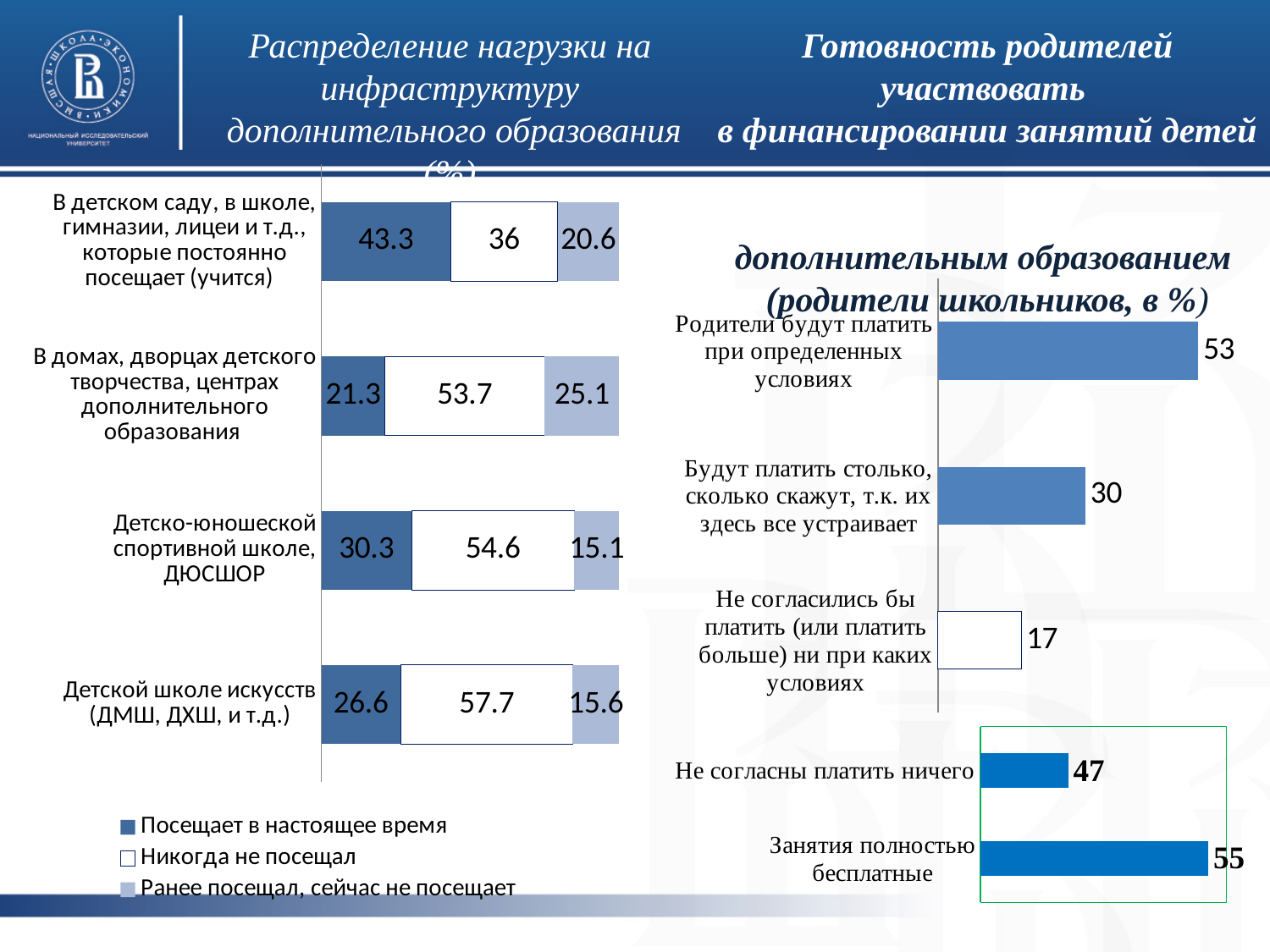
In the left chart, how many series does the legend list? 3 In the left chart, what is the value of 'Ранее посещал, сейчас не посещает' for 'В домах, дворцах детского творчества, центрах дополнительного образования'? 25.1 In the left chart 'Распределение нагрузки на инфраструктуру дополнительного образования', what is the value of 'Посещает в настоящее время' for 'Детско-юношеской спортивной школе, ДЮСШОР'? 30.3 What type of chart is the left chart? Stacked bar chart In the left chart, what is the difference between 'Никогда не посещал' and 'Посещает в настоящее время' for 'В домах, дворцах детского творчества, центрах дополнительного образования'? 32.4 In the right-top chart, which category has the lowest value? Не согласились бы платить (или платить больше) ни при каких условиях In the right-bottom chart, which is larger: 'Не согласны платить ничего' or 'Занятия полностью бесплатные'? Занятия полностью бесплатные In the left chart, what is the value of 'Никогда не посещал' for 'Детской школе искусств (ДМШ, ДХШ, и т.д.)'? 57.7 In the left chart, which category has the highest value for 'Посещает в настоящее время'? В детском саду, в школе, гимназии, лицеи и т.д., которые постоянно посещает (учится) In the right-top chart, what is the difference between 'Родители будут платить при определенных условиях' and 'Будут платить столько, сколько скажут, т.к. их здесь все устраивает'? 23 In the right-top chart 'Готовность родителей участвовать в финансировании занятий детей', what is the value for 'Родители будут платить при определенных условиях'? 53 In the left chart, how many categories are shown? 4